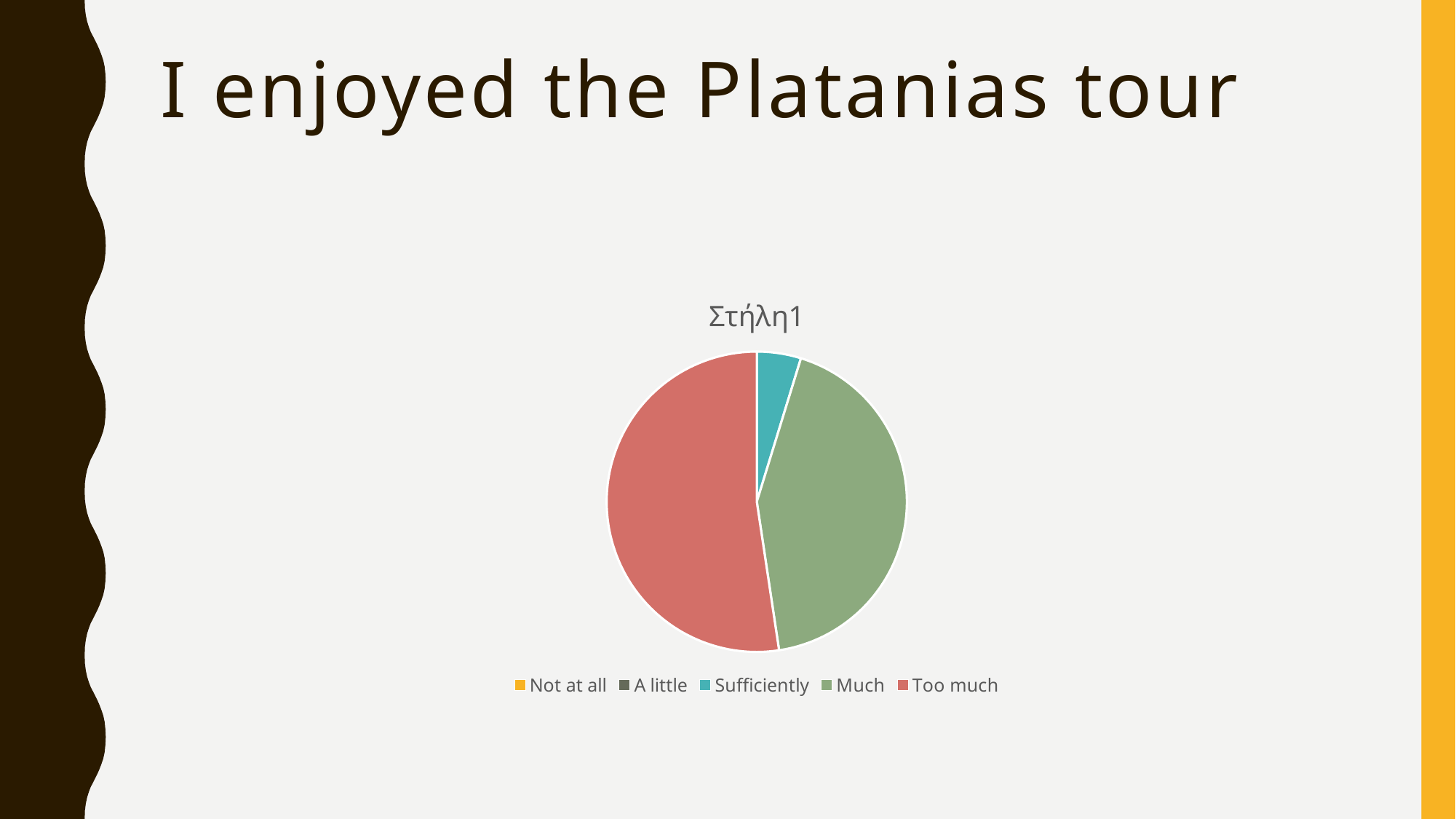
What is the title printed above the pie chart? Στήλη1 Which slice is larger, Too much or Much? Too much How many slices are visible in the pie chart? 3 Is the share of the pie for Sufficiently greater or less than 25%? less Which of the visible slices in the pie is the smallest? Sufficiently Which category has the largest slice of the pie? Too much Is the share of the pie for Too much greater or less than 25%? greater What kind of chart is shown on the slide? pie chart How many entries does the legend of the pie chart list? 5 Which slice is larger, Sufficiently or Much? Much What colour is the slice for Much in the pie chart? green Is the share of the pie for Much greater or less than 25%? greater